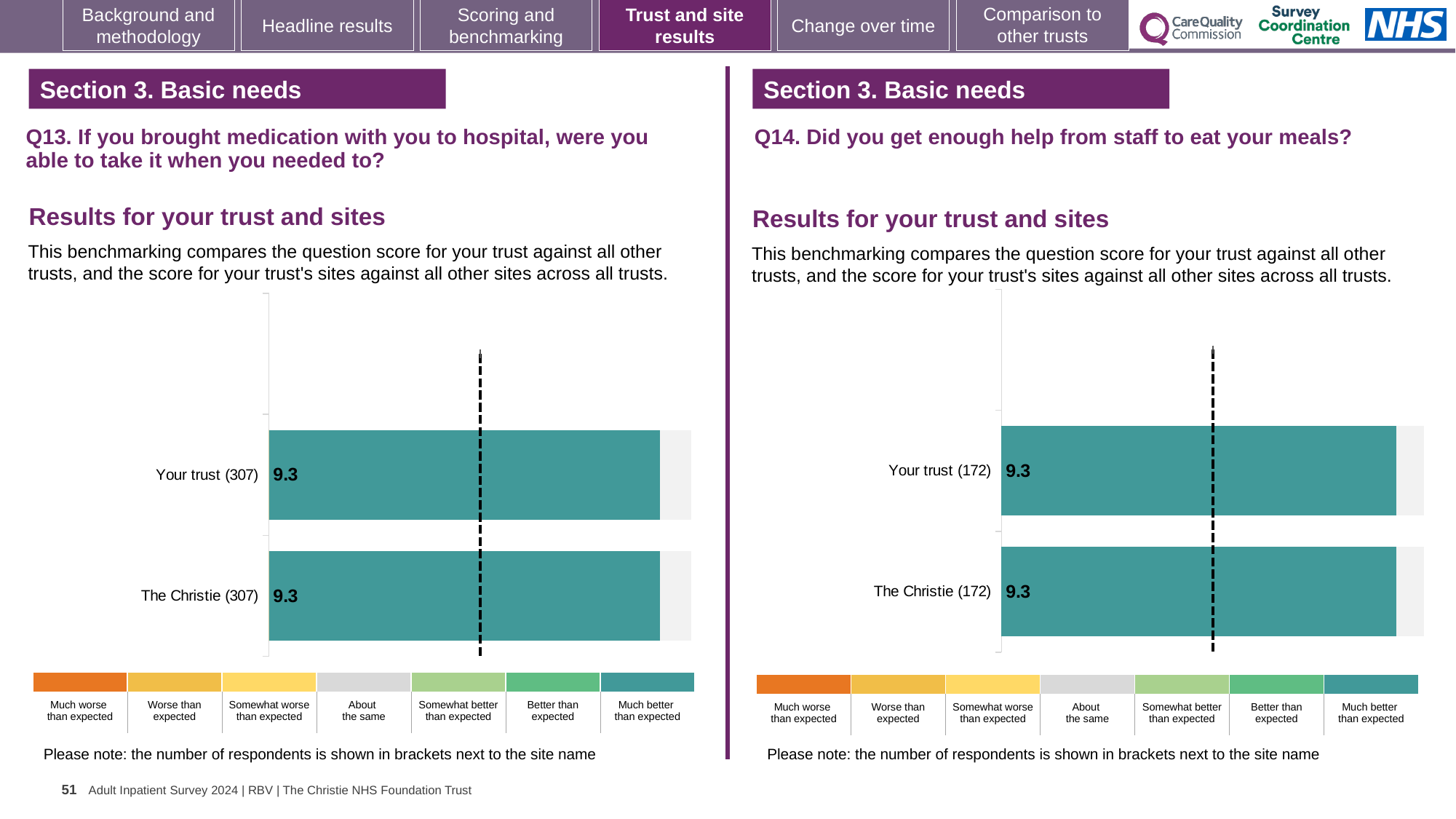
In the Q13 chart on the left, how many respondents are shown in brackets next to Your trust? 307 In the Q13 chart on the left, what is the score for The Christie? 9.3 In the Q14 chart on the right, is the score for Your trust the same as the score for The Christie? Yes How many bars are plotted in the Q14 chart on the right? 2 In the Q13 chart on the left, what is the score for Your trust? 9.3 In the Q14 chart on the right, what is the score for Your trust? 9.3 In the Q14 chart on the right, what is the score for The Christie? 9.3 In the Q14 chart on the right, what is the difference between the score for Your trust and the score for The Christie? 0 In the Q13 chart on the left, what is the difference between the score for Your trust and the score for The Christie? 0 How many bars are plotted in the Q13 chart on the left? 2 In the Q14 chart on the right, how many respondents are shown in brackets next to The Christie? 172 What kind of chart is used for the Q13 results on the left? Bar chart